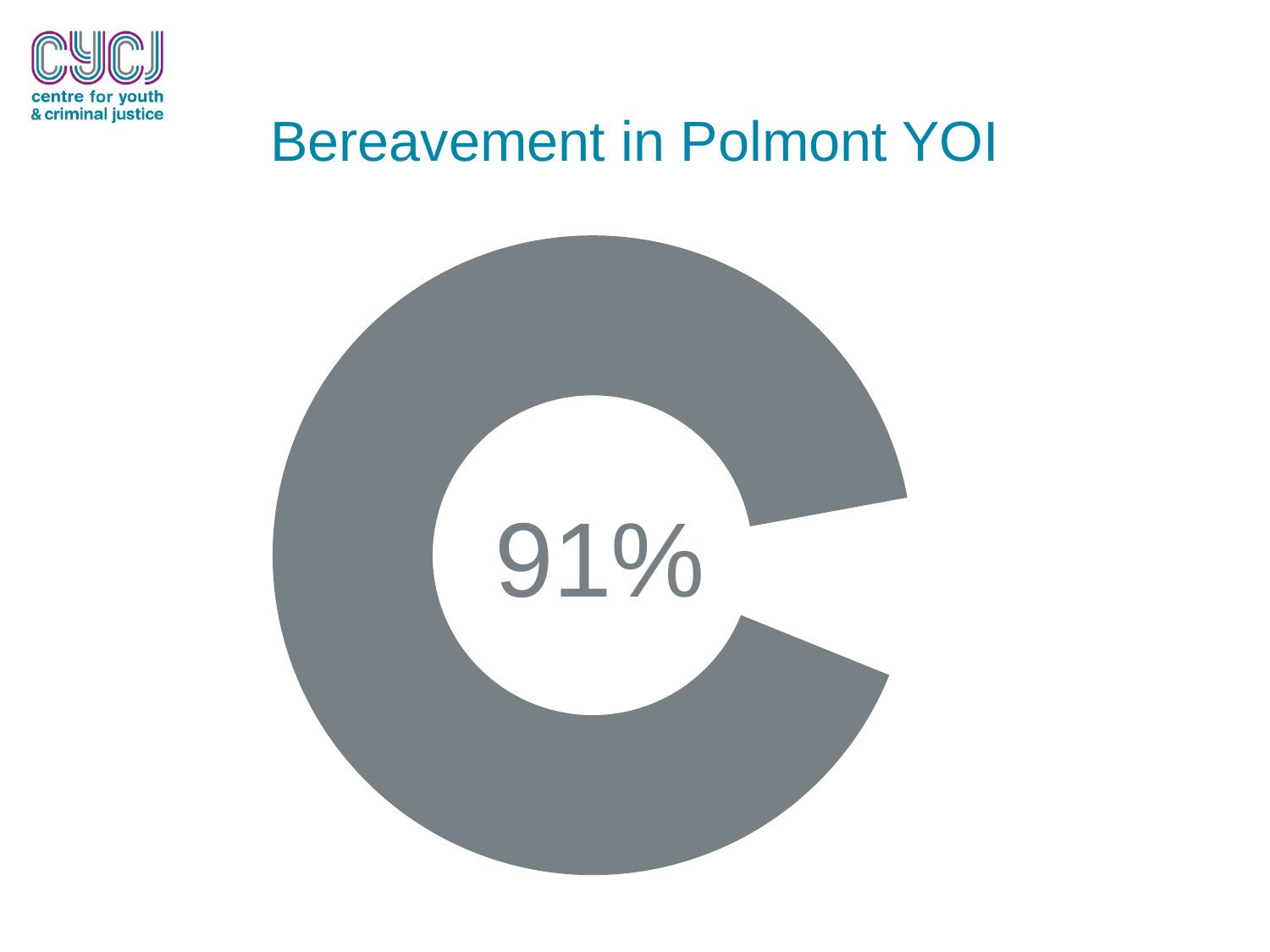
What kind of chart is shown on the slide? doughnut chart What percentage is printed in the centre of the doughnut chart? 91% Is the filled portion of the doughnut chart greater or less than 50%? greater How many filled segments does the doughnut chart show? 1 What colour is the filled segment of the doughnut chart? grey What share of the ring does the filled grey segment represent? 91% What is the title of the slide containing the doughnut chart? Bereavement in Polmont YOI